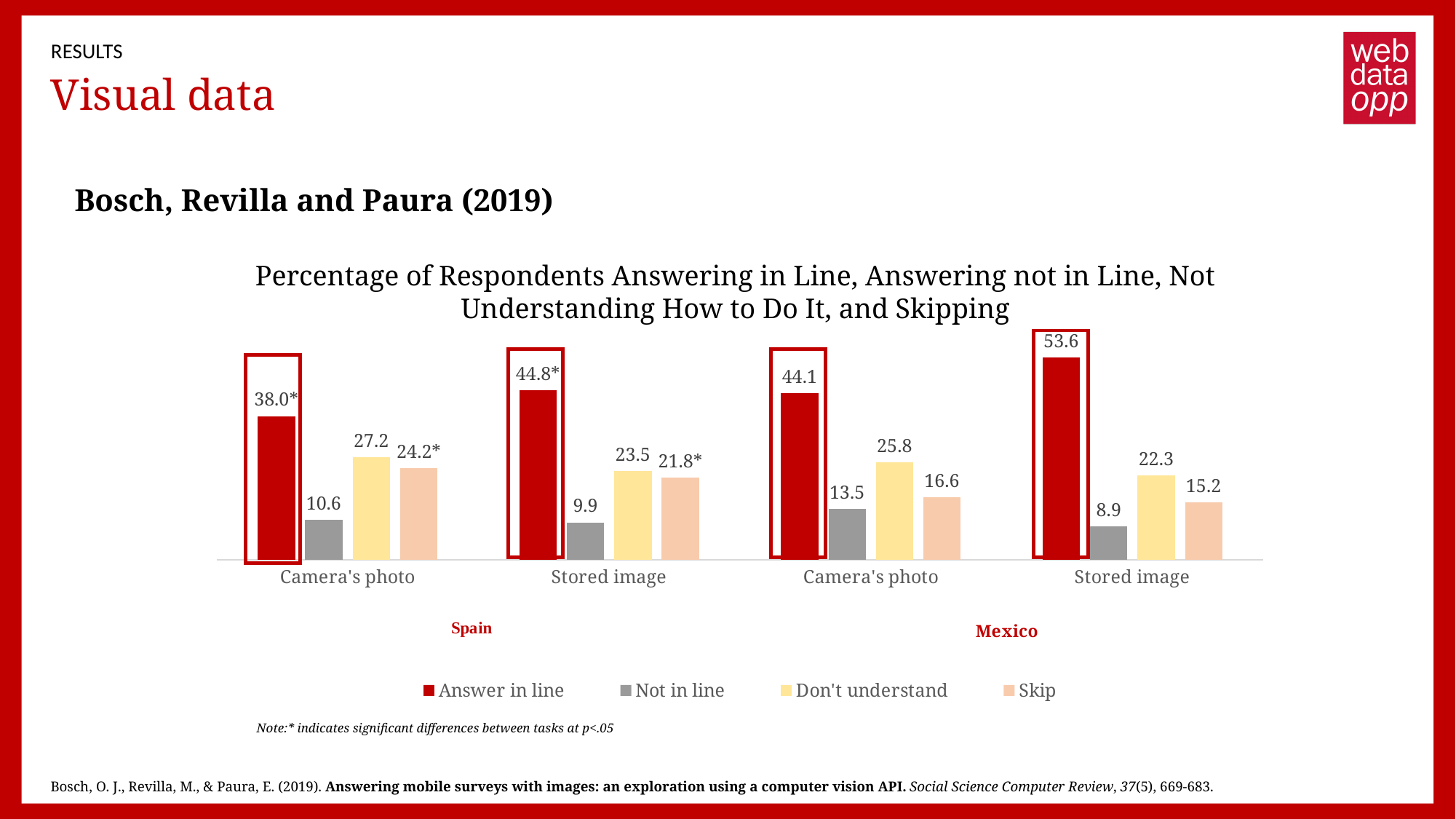
Which is larger for Camera's photo in Mexico: Don't understand or Skip? Don't understand How many category groups are shown on the x axis? 4 What is the value for Not in line for Camera's photo in Spain? 10.6 How many series does the legend list? 4 What is the value for Skip for Stored image in Mexico? 15.2 What is the value for Answer in line for Stored image in Mexico? 53.6 Which category group has the lowest Not in line value? Stored image (Mexico) What type of chart is shown on the slide? bar chart What is the value for Answer in line for Stored image in Spain? 44.8* What is the difference between the Answer in line value for Camera's photo in Mexico and the Not in line value for Camera's photo in Mexico? 30.6 Which category group has the highest Answer in line value? Stored image (Mexico) What is the value for Don't understand for Camera's photo in Mexico? 25.8